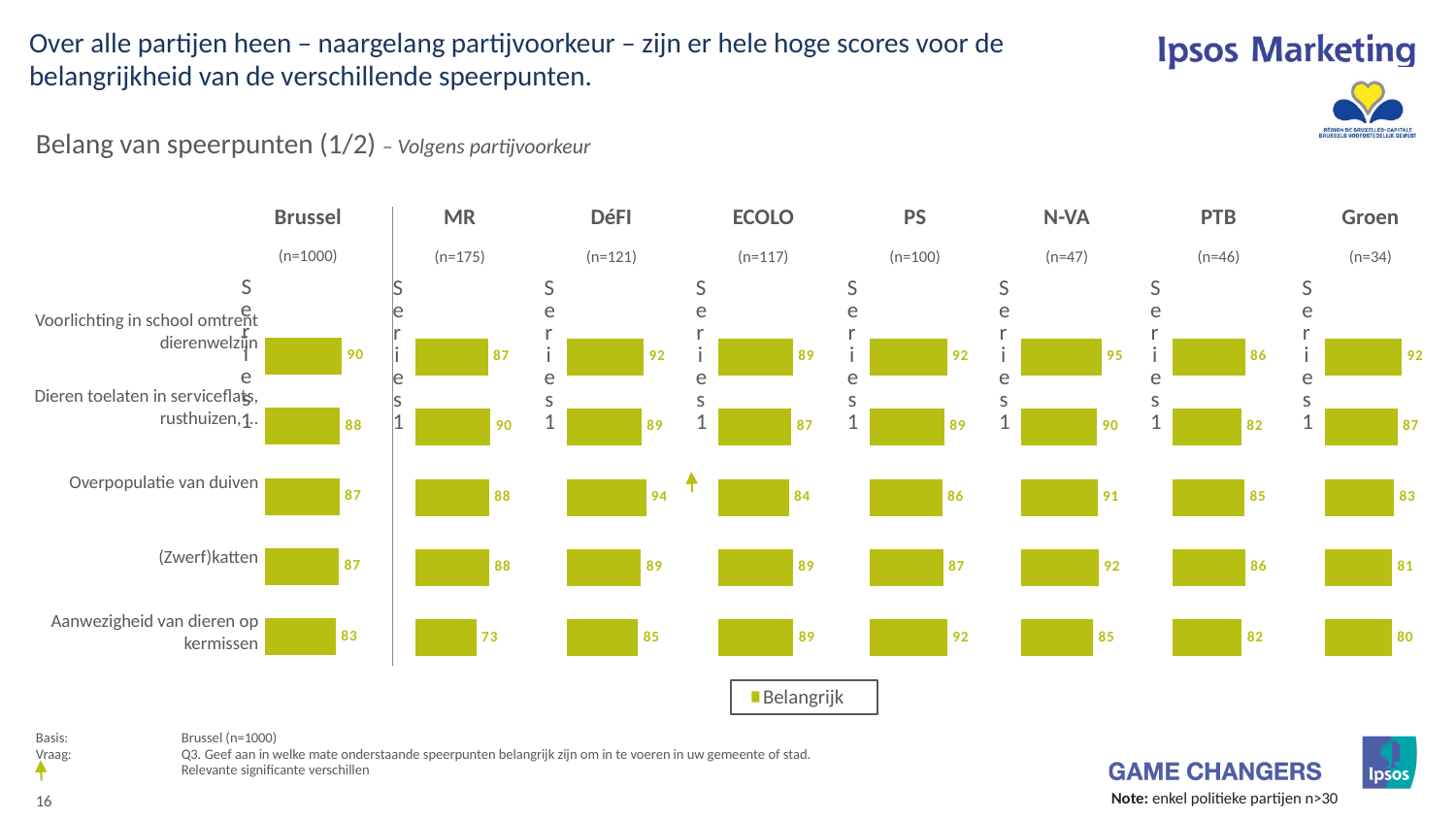
How many series does the legend list? 1 In the PS chart, which is larger: Overpopulatie van duiven or Aanwezigheid van dieren op kermissen? Aanwezigheid van dieren op kermissen In the DéFI chart, which category has the highest value? Overpopulatie van duiven In the Brussel chart, what is the value for Voorlichting in school omtrent dierenwelzijn? 90 In the MR chart, what is the value for Aanwezigheid van dieren op kermissen? 73 What is the legend entry shown below the charts? Belangrijk In the N-VA chart, which category has the lowest value? Aanwezigheid van dieren op kermissen How many categories are shown in the Brussel chart? 5 In the PTB chart, what is the value for Dieren toelaten in serviceflats, rusthuizen? 82 In the Groen chart, what is the difference between Voorlichting in school omtrent dierenwelzijn and Aanwezigheid van dieren op kermissen? 12 What kind of chart is used for the Brussel data? bar chart In the ECOLO chart, what is the value for Overpopulatie van duiven? 84